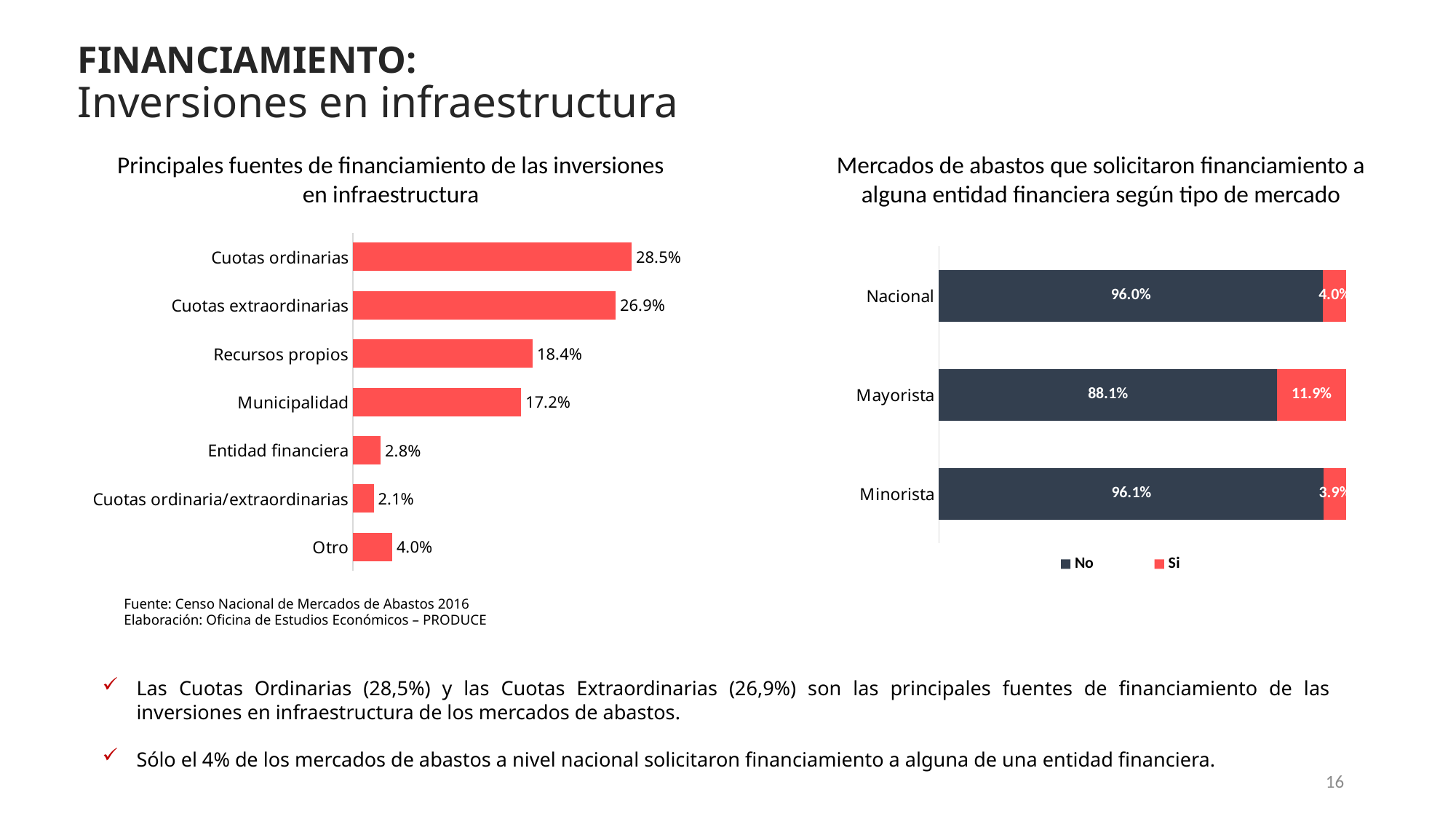
In the left chart (Principales fuentes de financiamiento de las inversiones en infraestructura), what is the difference between Cuotas ordinarias and Cuotas extraordinarias? 1.6% In the left chart (Principales fuentes de financiamiento de las inversiones en infraestructura), which category has the lowest value? Cuotas ordinaria/extraordinarias In the left chart (Principales fuentes de financiamiento de las inversiones en infraestructura), which category has the highest value? Cuotas ordinarias In the left chart (Principales fuentes de financiamiento de las inversiones en infraestructura), what is the value for Cuotas ordinarias? 28.5% In the right chart (Mercados de abastos que solicitaron financiamiento a alguna entidad financiera según tipo de mercado), how many series does the legend list? 2 What type of chart is the right chart (Mercados de abastos que solicitaron financiamiento a alguna entidad financiera según tipo de mercado)? Stacked bar chart In the left chart (Principales fuentes de financiamiento de las inversiones en infraestructura), how many categories are shown? 7 In the left chart (Principales fuentes de financiamiento de las inversiones en infraestructura), which is larger: Recursos propios or Municipalidad? Recursos propios In the right chart (Mercados de abastos que solicitaron financiamiento a alguna entidad financiera según tipo de mercado), which market type has the highest 'Si' value? Mayorista In the right chart (Mercados de abastos que solicitaron financiamiento a alguna entidad financiera según tipo de mercado), what is the 'No' value for Minorista? 96.1% In the left chart (Principales fuentes de financiamiento de las inversiones en infraestructura), what is the value for Municipalidad? 17.2% In the right chart (Mercados de abastos que solicitaron financiamiento a alguna entidad financiera según tipo de mercado), what is the 'Si' value for Mayorista? 11.9%